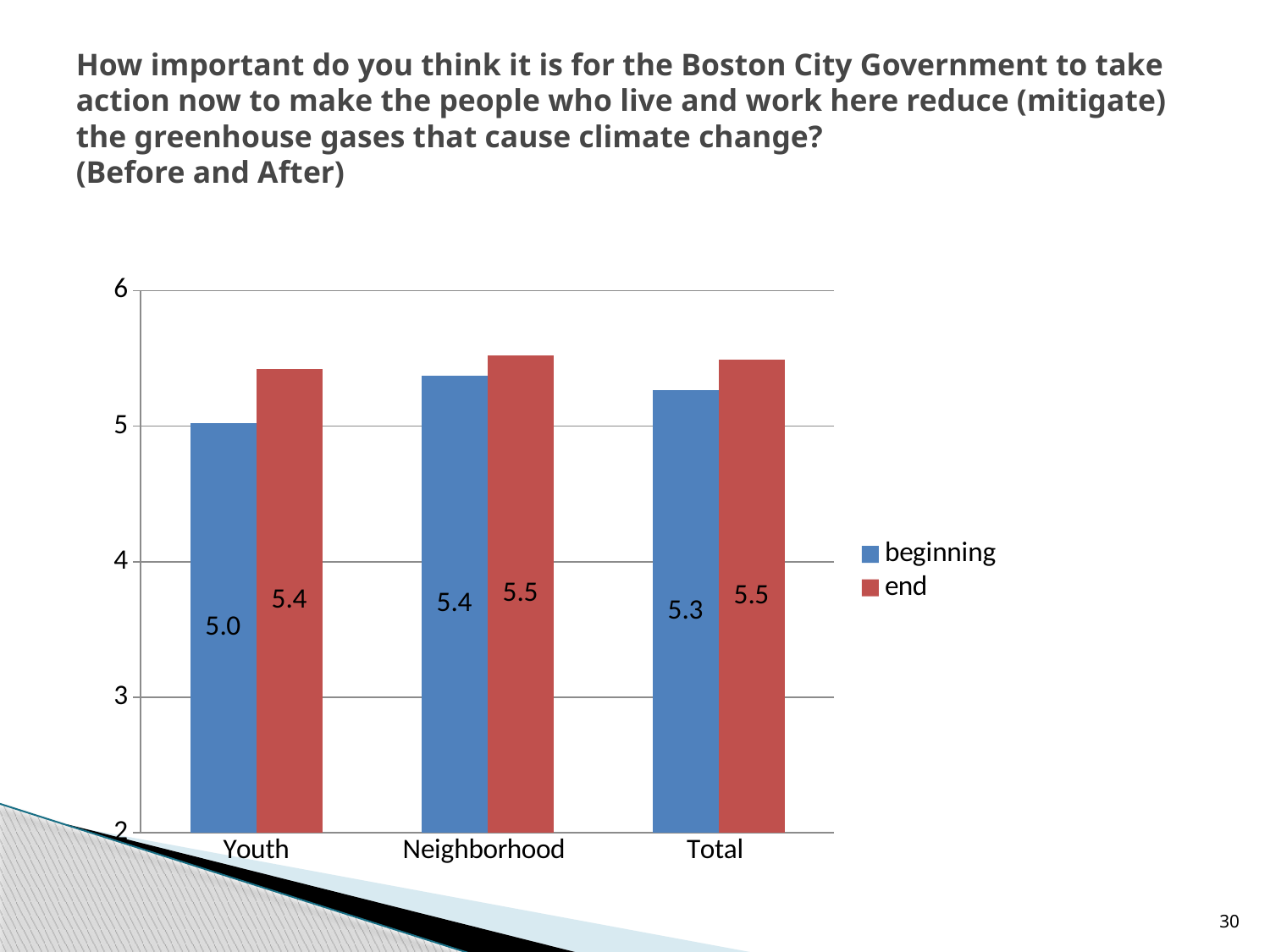
What is the 'end' value for Neighborhood? 5.5 What is the difference between the 'end' and 'beginning' values for Total? 0.2 How many series does the legend list? 2 What type of chart is shown on the slide? bar chart What is the 'beginning' value for Youth? 5.0 What is the 'beginning' value for Total? 5.3 How many categories are shown on the x axis? 3 For Youth, which is larger: the 'beginning' value or the 'end' value? end What is the 'end' value for Total? 5.5 Which category has the lowest 'beginning' value? Youth What is the difference between the 'end' and 'beginning' values for Youth? 0.4 Which category has the highest 'beginning' value? Neighborhood